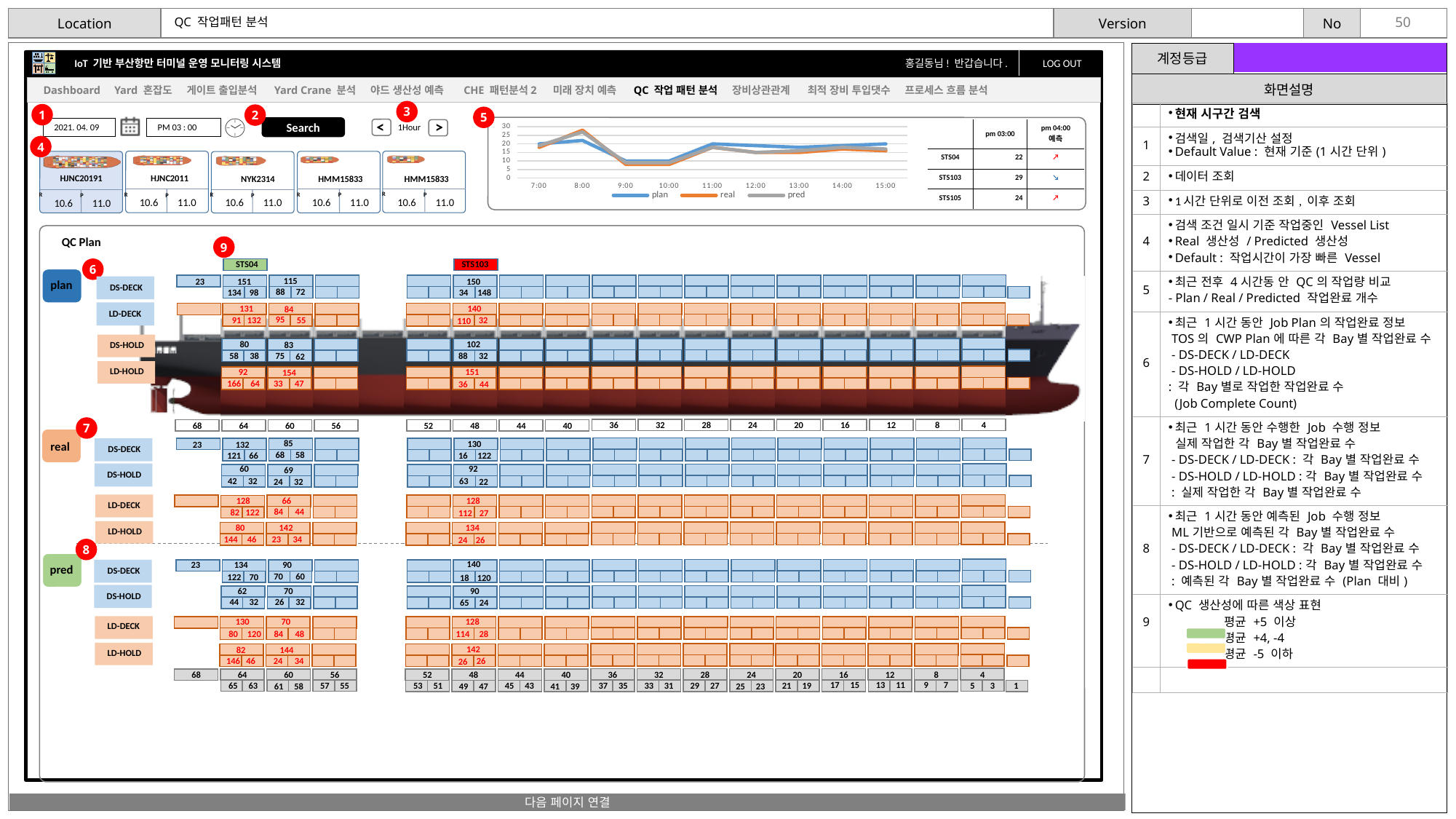
What is the highest tick value shown on the y axis of the line chart? 30 In the line chart, do the series values rise or fall between 8:00 and 9:00? fall In the line chart, do the series values rise or fall between 9:00 and 11:00? rise In the line chart, is the value of the plan series at 15:00 greater or less than 15? greater How many time points are labelled on the x axis of the line chart? 9 What are the three series named in the legend of the line chart? plan, real, pred In the table beside the line chart, what is the pm 03:00 value for STS103? 29 In the line chart, which series has the higher value at 8:00, plan or real? real What kind of chart is shown in the top panel (item 5) with the plan, real and pred series? line chart In the line chart, is the value of the real series at 8:00 greater or less than 20? greater How many series does the legend of the line chart list? 3 In the line chart, is the value of the plan series at 9:00 greater or less than 15? less